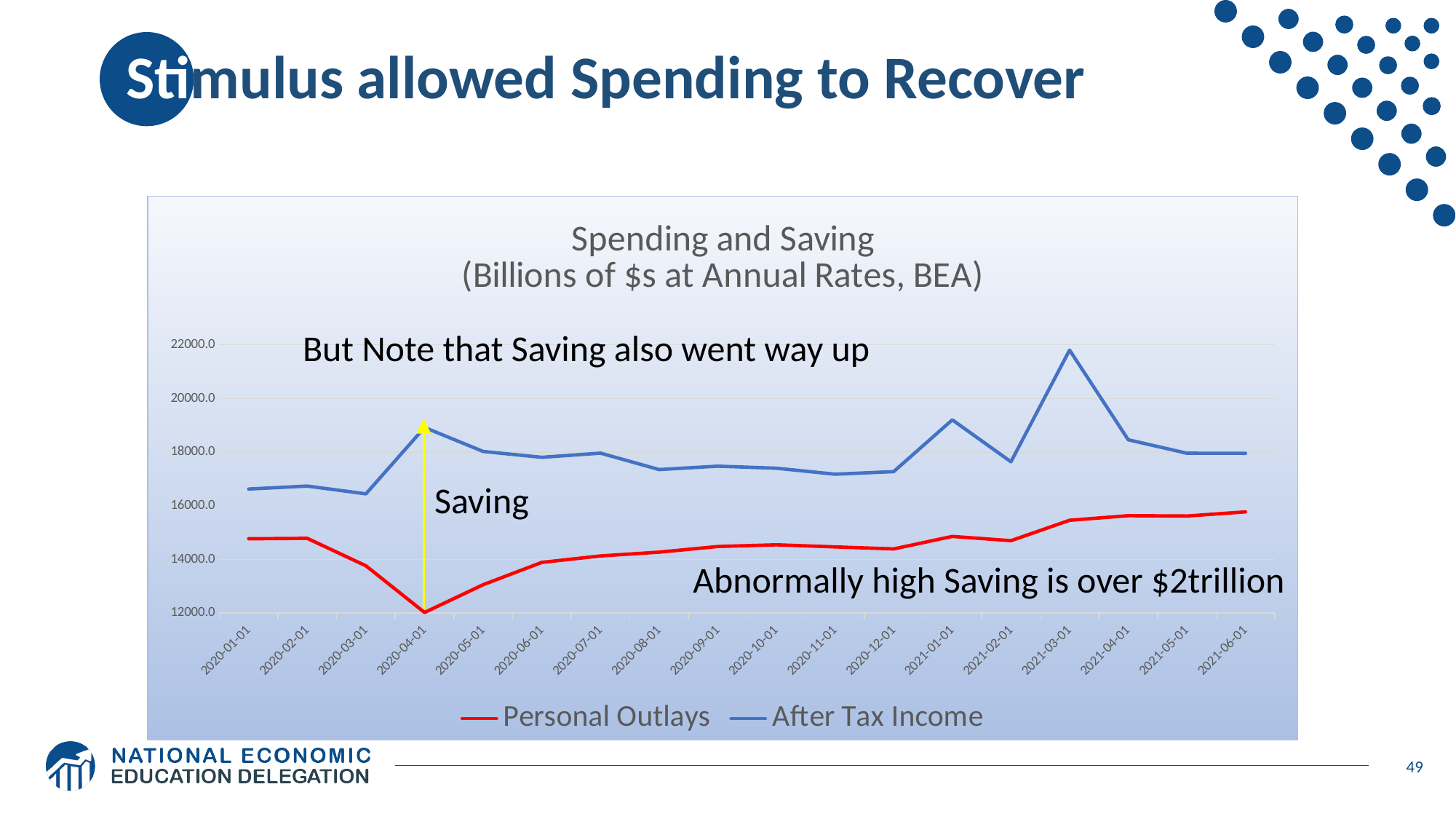
What kind of chart is shown on the slide? Line chart Is the value of After Tax Income at 2021-03-01 greater or less than 20000.0? greater At which date does After Tax Income reach its highest value? 2021-03-01 Which series is higher at 2020-12-01, Personal Outlays or After Tax Income? After Tax Income Do Personal Outlays rise or fall between 2020-04-01 and 2021-06-01? Rise How many dates are plotted along the x axis of the chart? 18 Which colour is used for the After Tax Income line? Blue What is the title of the chart? Spending and Saving (Billions of $s at Annual Rates, BEA) Is the value of Personal Outlays at 2020-04-01 greater or less than 14000.0? less How many series does the chart legend list? 2 Is the value of After Tax Income at 2020-08-01 greater or less than 18000.0? less At which date do Personal Outlays reach their lowest value? 2020-04-01